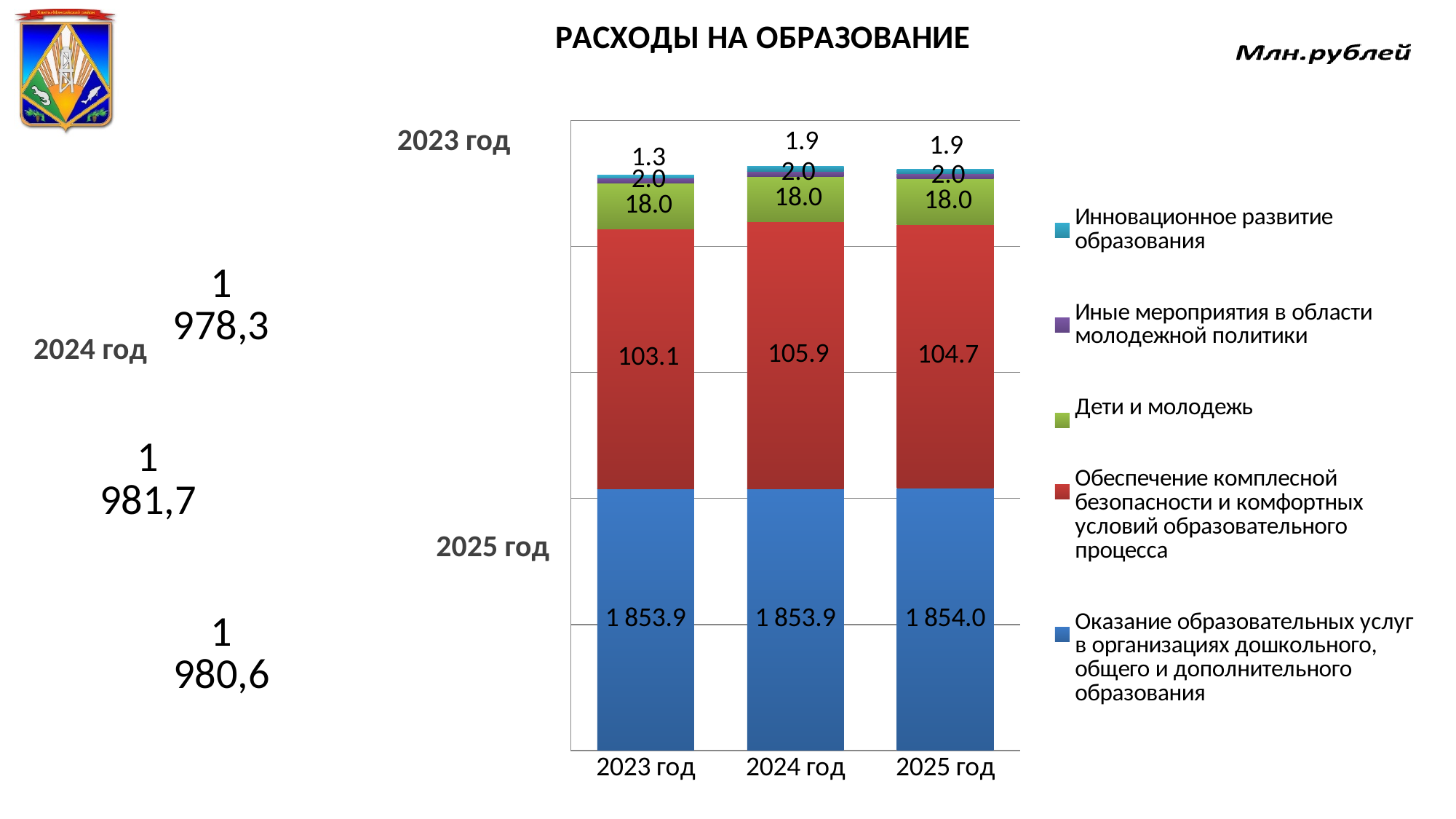
How many series does the legend list? 5 What is the value for "Оказание образовательных услуг в организациях дошкольного, общего и дополнительного образования" in 2025 год? 1 854.0 What is the value for "Инновационное развитие образования" in 2023 год? 1.3 How many years (categories) are shown on the x axis? 3 What type of chart is shown on the slide? Stacked bar chart What is the difference between the "Обеспечение комплесной безопасности и комфортных условий образовательного процесса" values for 2024 год and 2023 год? 2.8 What is the total of the stacked bar for 2023 год? 1 978,3 What is the value for "Дети и молодежь" in 2025 год? 18.0 In which year is the value for "Инновационное развитие образования" the lowest? 2023 год What is the value for "Обеспечение комплесной безопасности и комфортных условий образовательного процесса" in 2024 год? 105.9 What is the title of the chart? РАСХОДЫ НА ОБРАЗОВАНИЕ In which year is the value for "Обеспечение комплесной безопасности и комфортных условий образовательного процесса" the highest? 2024 год